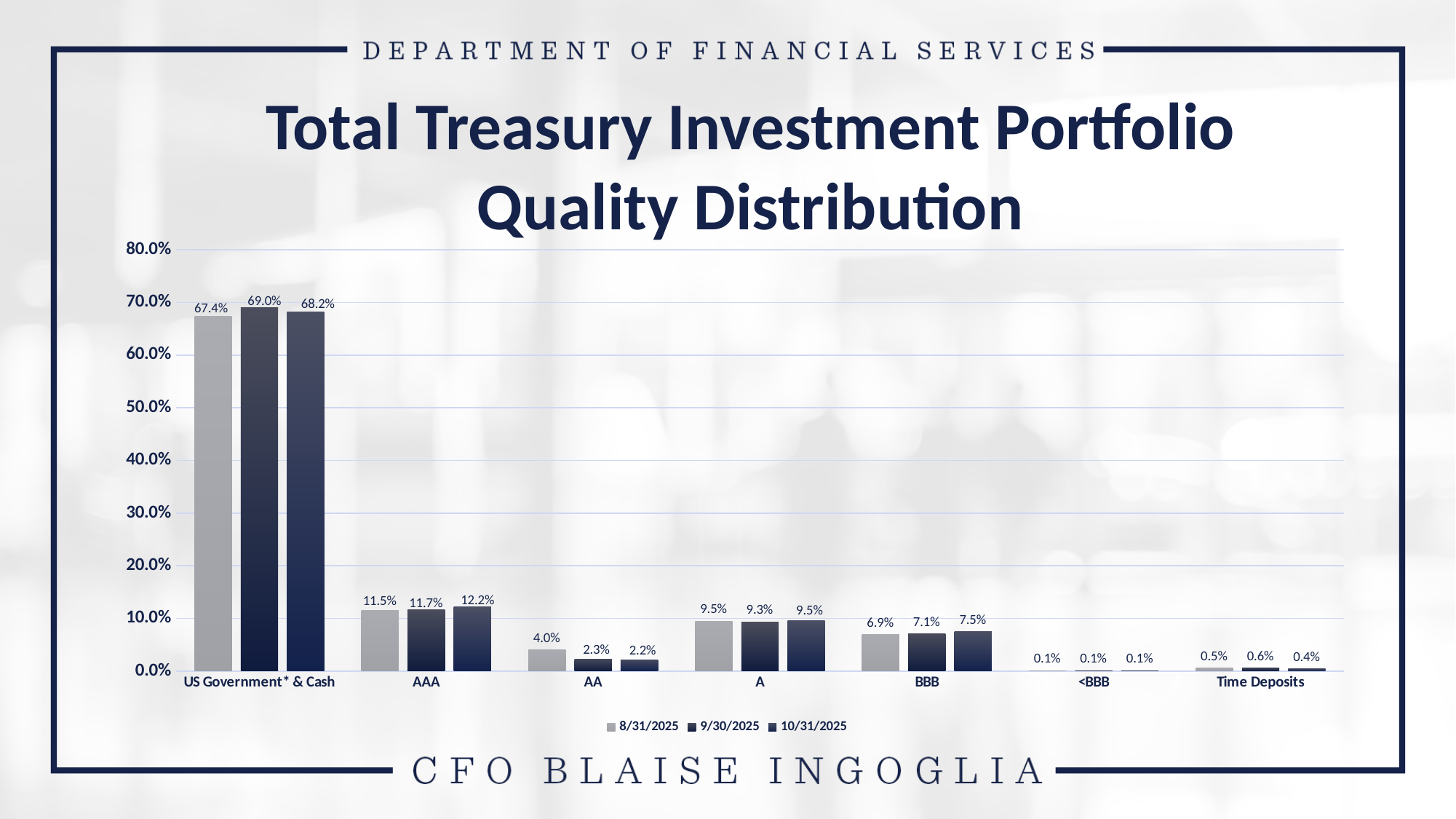
What is the value for US Government* & Cash for the 9/30/2025 series? 69.0% What is the value for Time Deposits for the 10/31/2025 series? 0.4% How many series does the legend list? 3 What kind of chart is shown on the slide? Bar chart Is the value for US Government* & Cash for 8/31/2025 greater or less than 60.0%? greater Which category has the lowest value for the 8/31/2025 series? <BBB What is the value for AAA for the 10/31/2025 series? 12.2% What is the value for AA for the 8/31/2025 series? 4.0% Which category has the highest value for the 10/31/2025 series? US Government* & Cash How many categories are shown on the x axis? 7 What is the difference between the 10/31/2025 and 8/31/2025 values for BBB? 0.6% Which is larger for AA: the 9/30/2025 value or the 10/31/2025 value? 9/30/2025